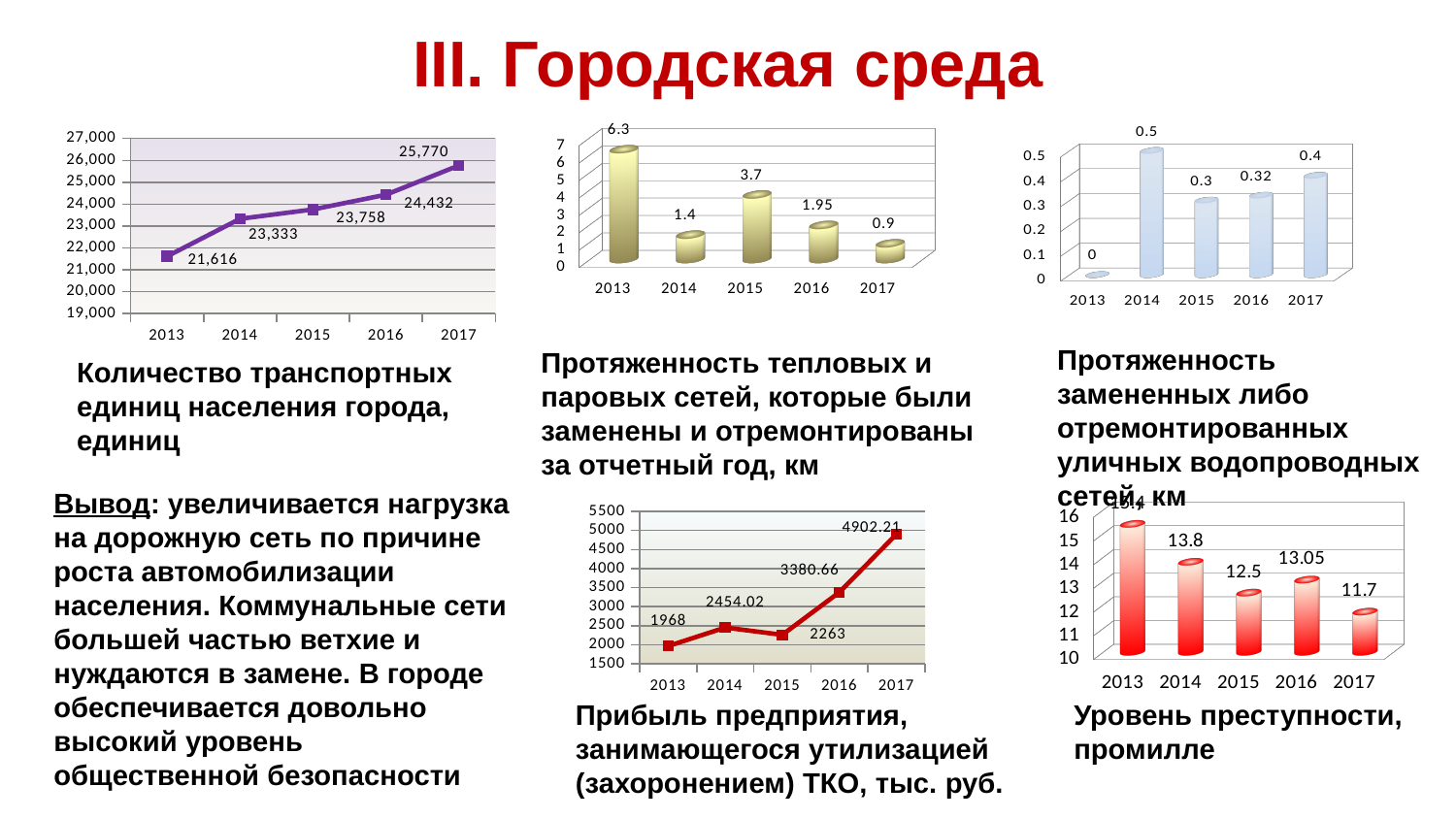
In the chart 'Протяженность замененных либо отремонтированных уличных водопроводных сетей, км', which year has the lowest value? 2013 In the chart 'Уровень преступности, промилле', what is the value for 2017? 11.7 In the chart 'Количество транспортных единиц населения города, единиц', do the values rise or fall from 2013 to 2017? rise In the chart 'Количество транспортных единиц населения города, единиц', what is the value for 2017? 25,770 In the chart 'Прибыль предприятия, занимающегося утилизацией (захоронением) ТКО, тыс. руб.', what is the value for 2017? 4902.21 In the chart 'Протяженность замененных либо отремонтированных уличных водопроводных сетей, км', what is the value for 2016? 0.32 In the chart 'Протяженность тепловых и паровых сетей, которые были заменены и отремонтированы за отчетный год, км', what is the value for 2016? 1.95 What kind of chart is 'Протяженность тепловых и паровых сетей, которые были заменены и отремонтированы за отчетный год, км'? bar chart In the chart 'Количество транспортных единиц населения города, единиц', what is the difference between the 2014 and 2013 values? 1,717 In the chart 'Прибыль предприятия, занимающегося утилизацией (захоронением) ТКО, тыс. руб.', which is larger, the value for 2014 or the value for 2015? 2014 In the chart 'Протяженность тепловых и паровых сетей, которые были заменены и отремонтированы за отчетный год, км', which year has the highest value? 2013 How many years are plotted in the chart 'Уровень преступности, промилле'? 5